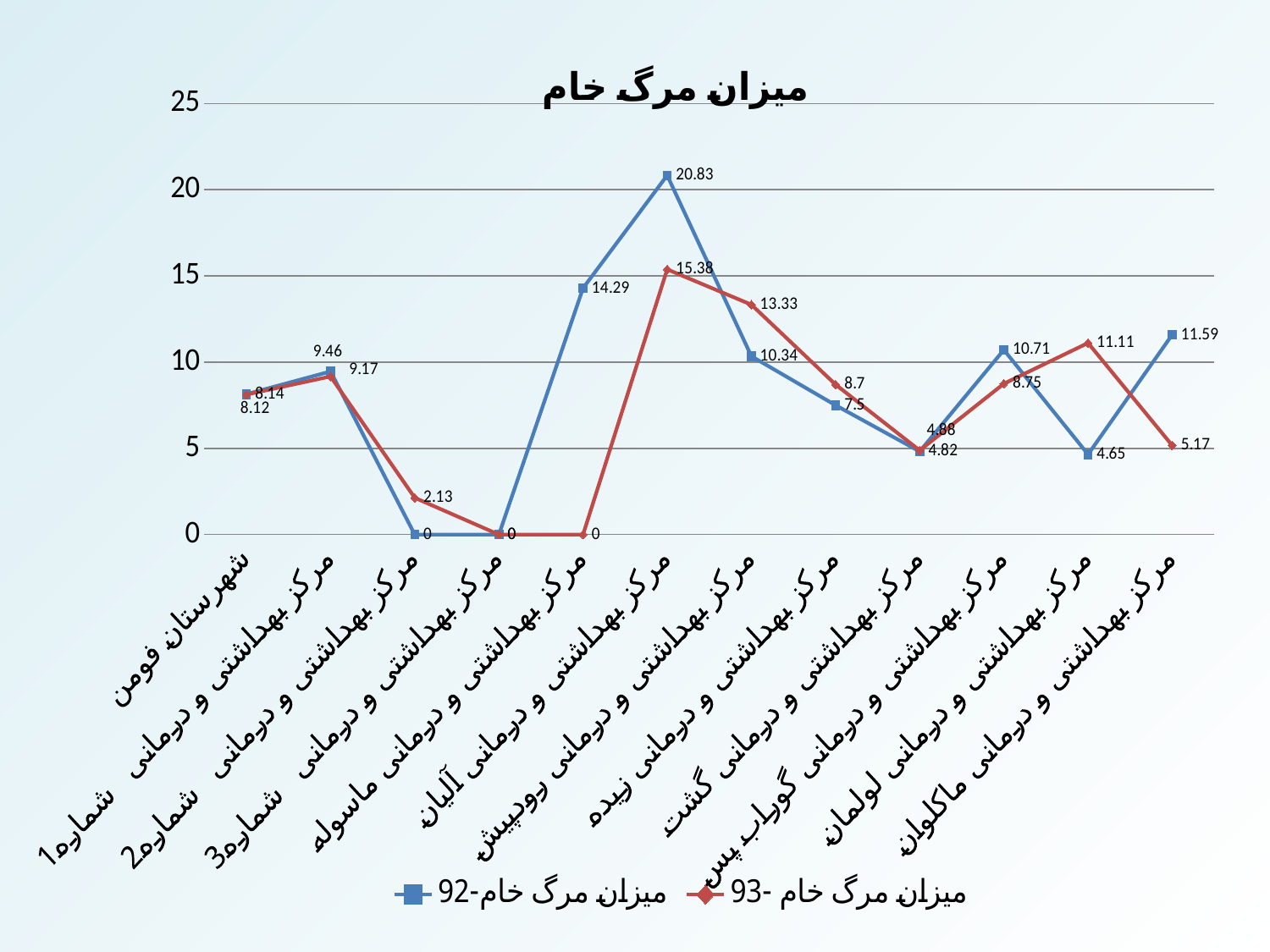
What is the difference between the 'میزان مرگ خام-92' and 'میزان مرگ خام -93' values for 'مرکز بهداشتی و درمانی آلیان'? 5.45 What is the title of the chart? میزان مرگ خام Which category has the highest value in the 'میزان مرگ خام -93' series? مرکز بهداشتی و درمانی آلیان For 'مرکز بهداشتی و درمانی ماکلوان', which series has the larger value, 'میزان مرگ خام-92' or 'میزان مرگ خام -93'? میزان مرگ خام-92 What is the value of the 'میزان مرگ خام-92' series for 'مرکز بهداشتی و درمانی آلیان'? 20.83 What is the value of the 'میزان مرگ خام -93' series for 'مرکز بهداشتی و درمانی لولمان'? 11.11 How many categories are shown on the x axis? 12 Which category has the highest value in the 'میزان مرگ خام-92' series? مرکز بهداشتی و درمانی آلیان What is the value of the 'میزان مرگ خام -93' series for 'مرکز بهداشتی و درمانی ماسوله'? 0 Is the value of the 'میزان مرگ خام-92' series for 'مرکز بهداشتی و درمانی ماسوله' greater or less than 10? greater How many series does the legend list? 2 What type of chart is shown on the slide? line chart